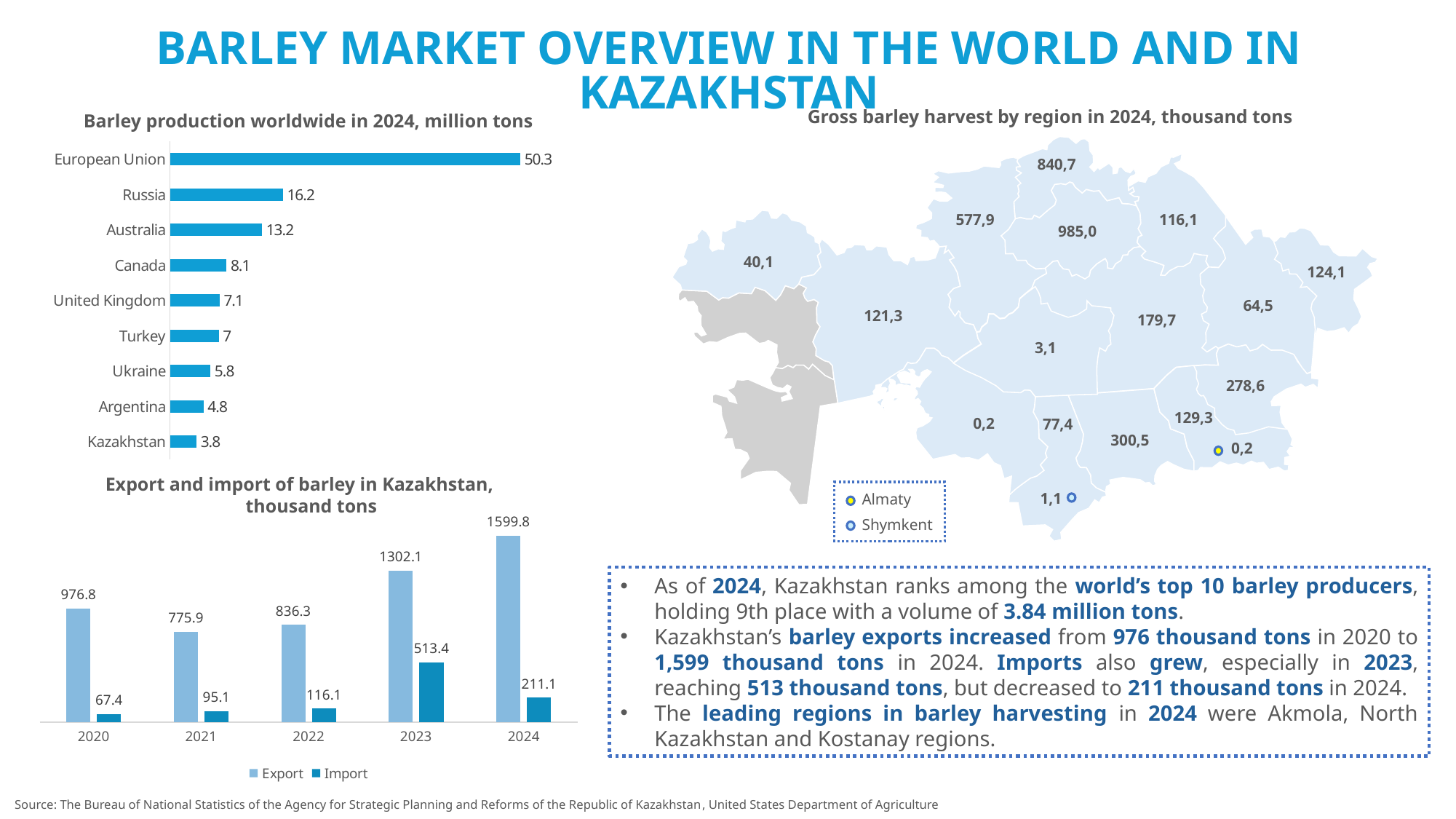
What kind of chart is 'Barley production worldwide in 2024, million tons'? Bar chart In the 'Export and import of barley in Kazakhstan, thousand tons' chart, is the Import value for 2021 larger or smaller than the Import value for 2022? Smaller In the 'Barley production worldwide in 2024, million tons' chart, what is the difference between the values for Australia and Canada? 5.1 In the 'Export and import of barley in Kazakhstan, thousand tons' chart, which year has the highest Export value? 2024 In the 'Export and import of barley in Kazakhstan, thousand tons' chart, how many series does the legend list? 2 In the 'Export and import of barley in Kazakhstan, thousand tons' chart, what is the difference between the Export and Import values for 2024? 1388.7 In the 'Barley production worldwide in 2024, million tons' chart, what is the value for Russia? 16.2 In the 'Export and import of barley in Kazakhstan, thousand tons' chart, what is the Export value for 2022? 836.3 In the 'Barley production worldwide in 2024, million tons' chart, which category has the lowest value? Kazakhstan In the 'Export and import of barley in Kazakhstan, thousand tons' chart, what is the Import value for 2023? 513.4 In the 'Barley production worldwide in 2024, million tons' chart, which category has the highest value? European Union In the 'Barley production worldwide in 2024, million tons' chart, how many countries or regions are shown? 9